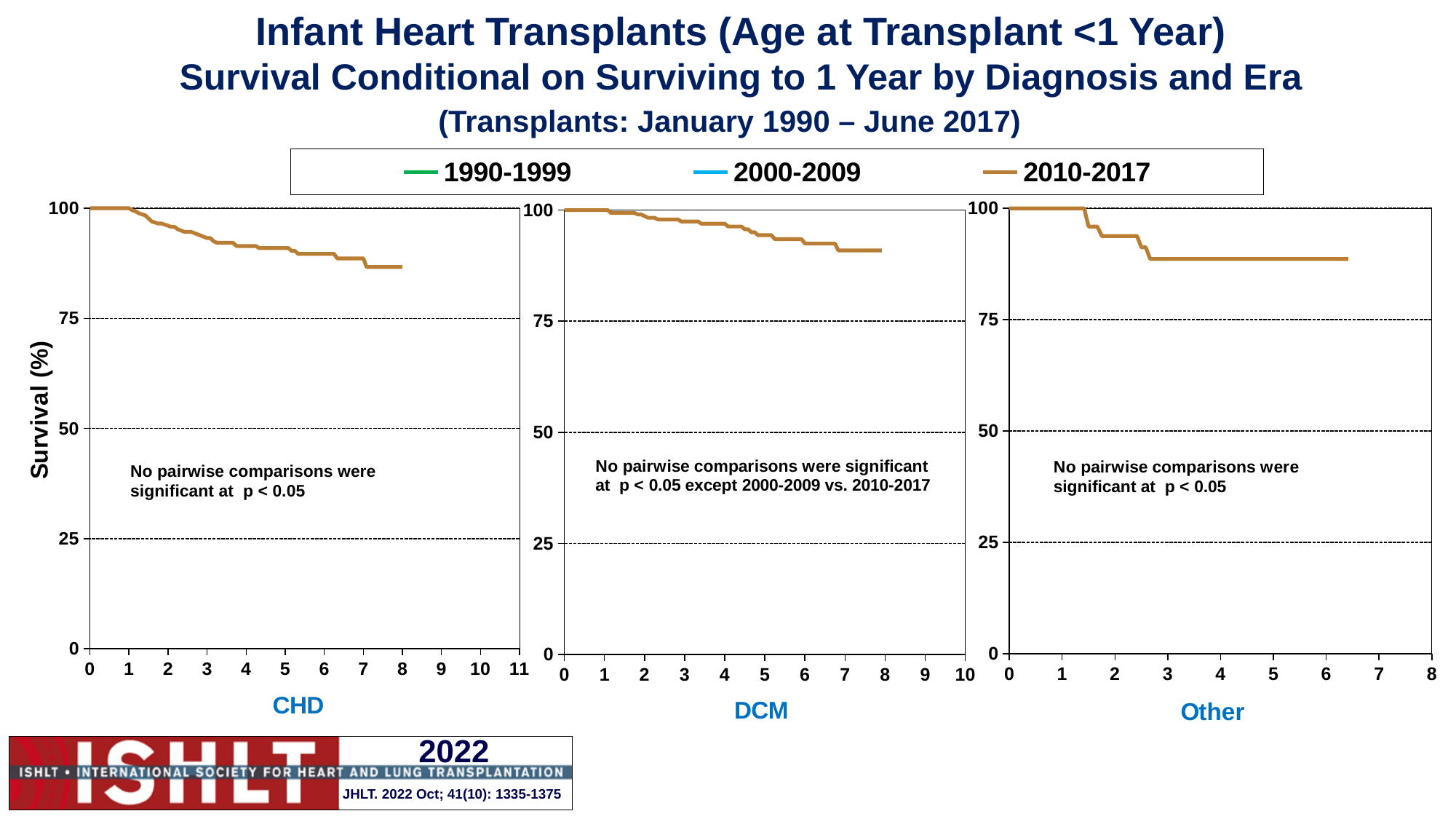
In the DCM chart, does the 2010-2017 survival curve rise or fall along the x axis? fall How many charts are shown on the slide? 3 How many series does the legend list? 3 In the Other chart, is the 2010-2017 survival value at year 6 greater or less than 75? greater What is the highest year shown on the x axis of the CHD chart? 11 Which era does the brown line in the legend represent? 2010-2017 What kind of chart is the CHD chart? line chart In the CHD chart, is the 2010-2017 survival value at year 8 greater or less than 75? greater In the DCM chart, is the 2010-2017 survival value at year 8 greater or less than 75? greater In the Other chart, what is the 2010-2017 survival value at year 0? 100 In the CHD chart, does the 2010-2017 survival curve rise or fall as years increase? fall